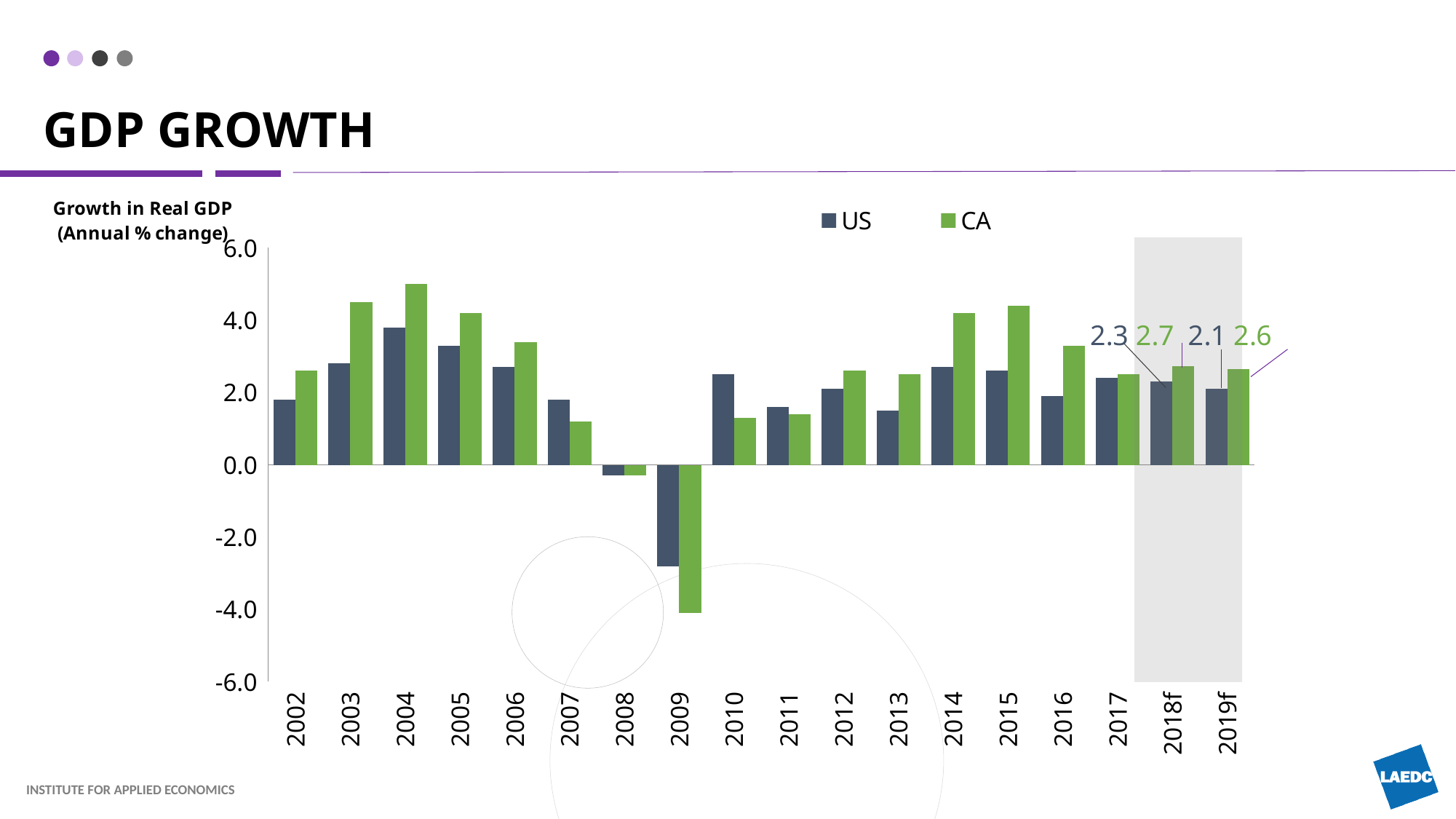
In which year is the CA value highest? 2004 What is the difference between the CA and US values for 2018f? 0.4 What is the CA value for 2019f? 2.6 Is the CA value for 2007 greater or less than 2.0? less How many years are shown on the x axis? 18 What is the US value for 2019f? 2.1 Is the US value for 2009 greater or less than -2.0? less Which series has the larger value in 2019f, US or CA? CA What kind of chart is shown on the slide? bar chart How many series does the legend list? 2 In which year is the CA value lowest? 2009 What is the US value for 2018f? 2.3